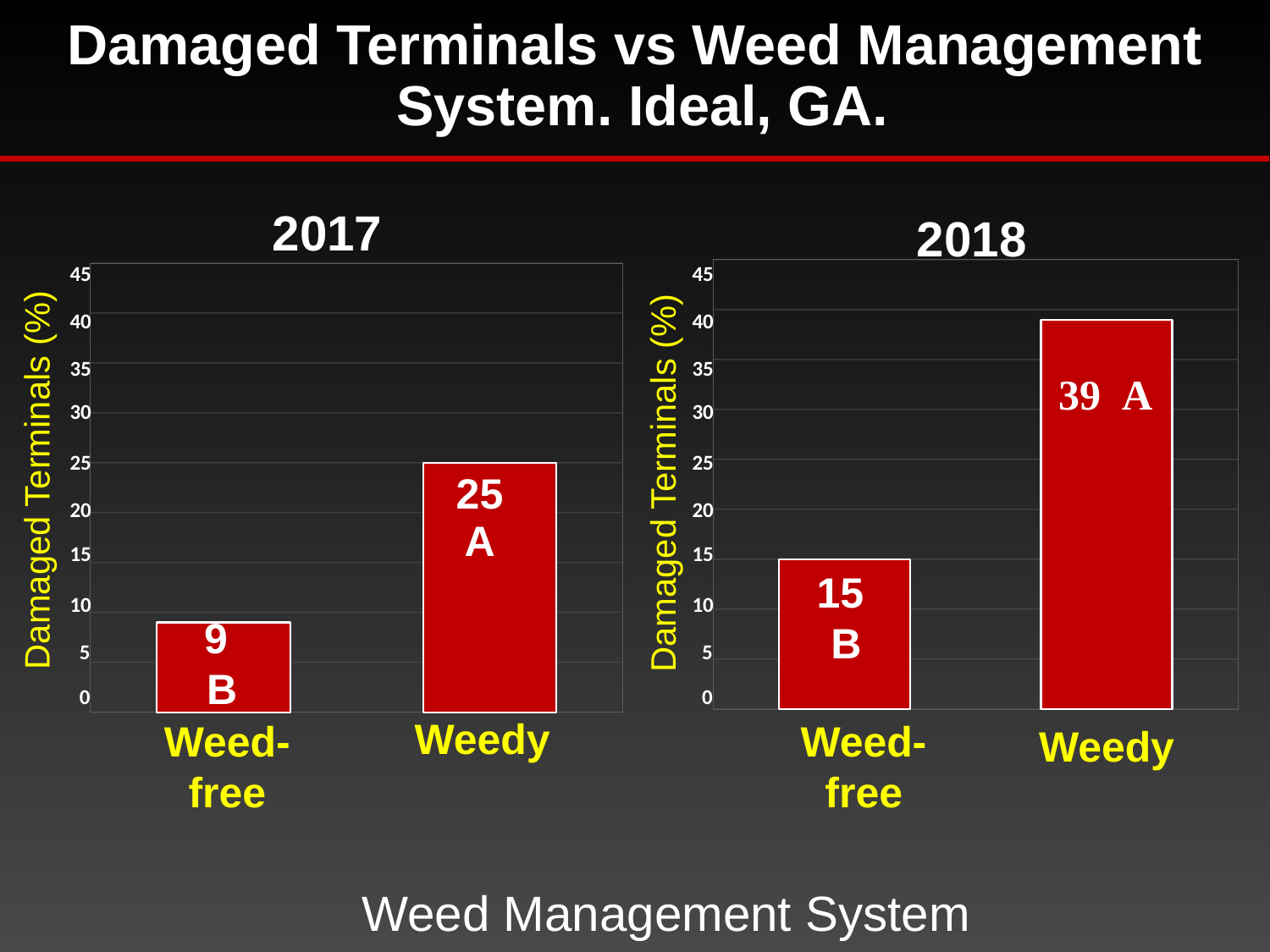
In the 2018 chart, which category has the lowest value? Weed-free How many categories are shown in the 2018 chart? 2 In the 2017 chart, what is the value for Weedy? 25 What kind of chart is the 2017 chart? bar chart In the 2018 chart, what is the value for Weedy? 39 In the 2018 chart, what is the value for Weed-free? 15 Is the Weed-free value in the 2018 chart larger or smaller than the Weed-free value in the 2017 chart? larger In the 2018 chart, what is the difference between the Weedy and Weed-free values? 24 In the 2017 chart, what is the value for Weed-free? 9 What is the y-axis label of the 2017 chart? Damaged Terminals (%) In the 2017 chart, which category has the highest value? Weedy In the 2017 chart, what is the difference between the Weedy and Weed-free values? 16